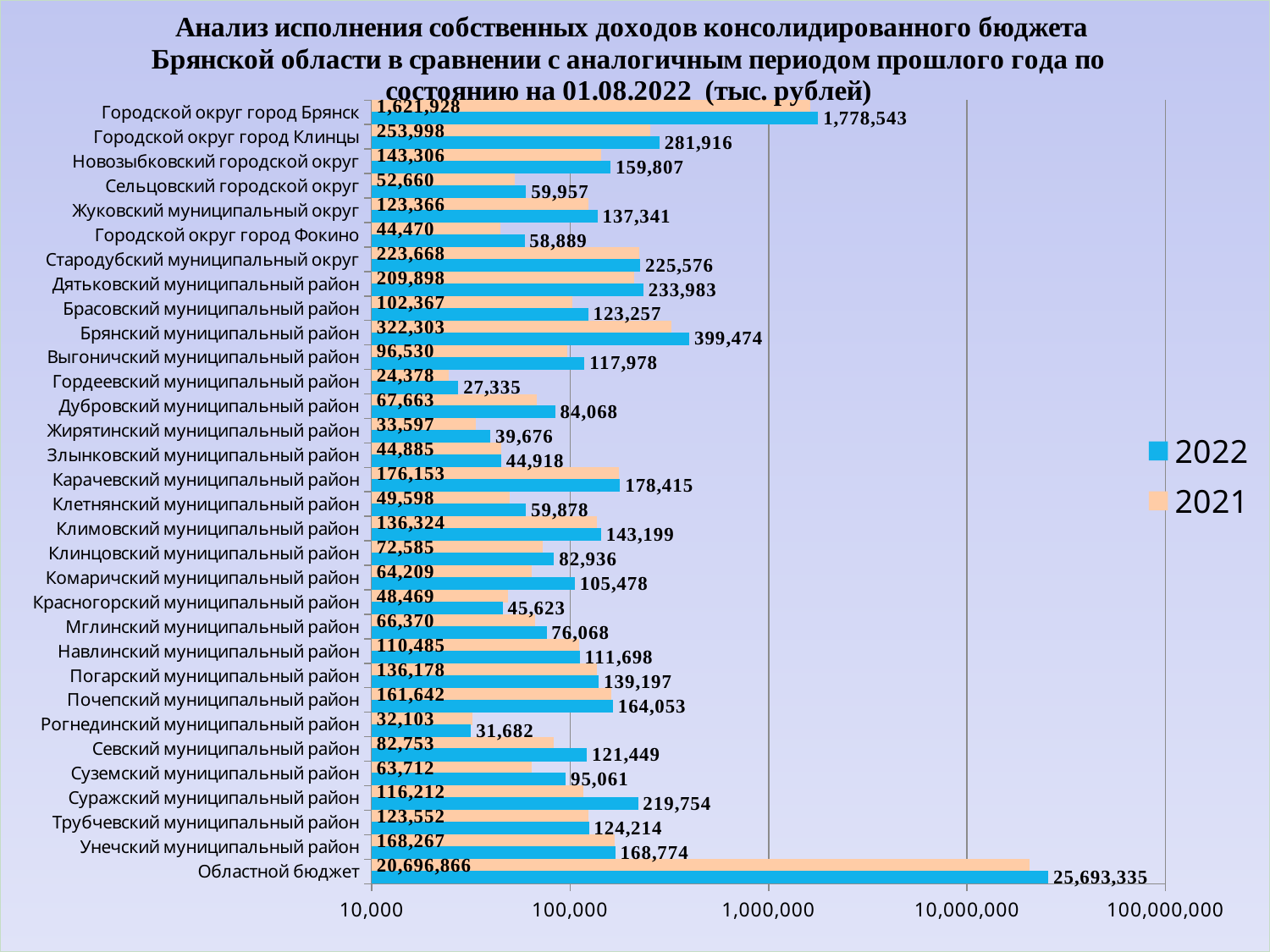
What is the 2022 value for Областной бюджет? 25,693,335 What is the difference between the 2022 and 2021 values for Сельцовский городской округ? 7,297 What is the difference between the 2022 and 2021 values for Городской округ город Брянск? 156,615 What is the 2022 value for Городской округ город Брянск? 1,778,543 What is the 2021 value for Брянский муниципальный район? 322,303 Which category has the highest 2022 value? Областной бюджет How many series does the legend list? 2 For Красногорский муниципальный район, which year has the larger value, 2022 or 2021? 2021 How many categories are shown on the chart? 32 For Суражский муниципальный район, which year has the larger value, 2022 or 2021? 2022 What kind of chart is shown on the slide? Bar chart Which category has the lowest 2022 value? Гордеевский муниципальный район